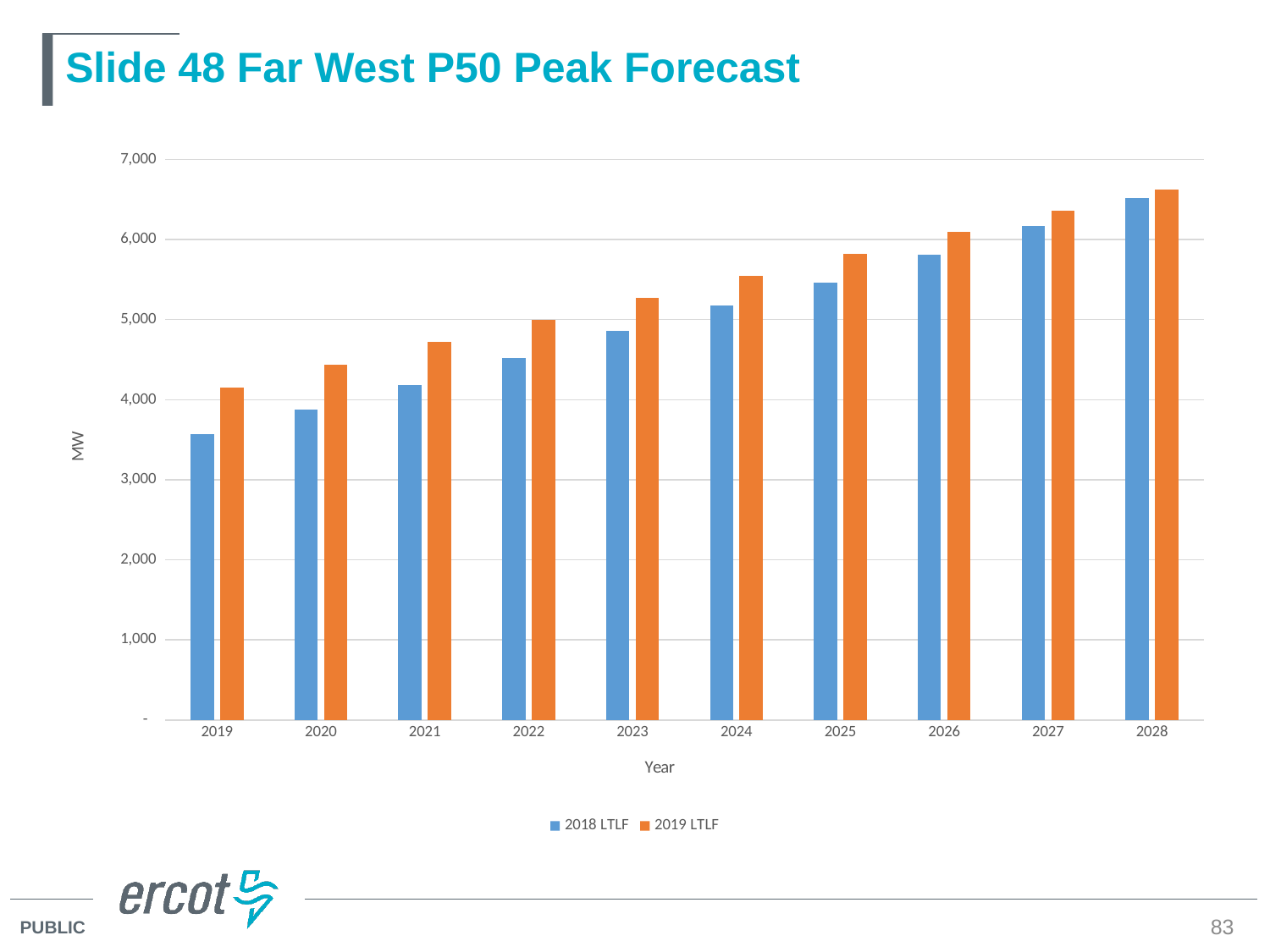
Is the 2018 LTLF value for 2028 greater or less than 6,000? greater Do the 2019 LTLF values rise or fall from 2019 to 2028? rise Which year has the highest 2019 LTLF value? 2028 What kind of chart is shown on the slide? bar chart Is the 2018 LTLF value for 2019 greater or less than 4,000? less Which year has the lowest 2018 LTLF value? 2019 Is the 2019 LTLF value for 2024 greater or less than 5,000? greater In 2019, which series has the larger value, 2018 LTLF or 2019 LTLF? 2019 LTLF How many series does the legend list? 2 What is the label on the vertical axis of the chart? MW How many years are shown on the x axis? 10